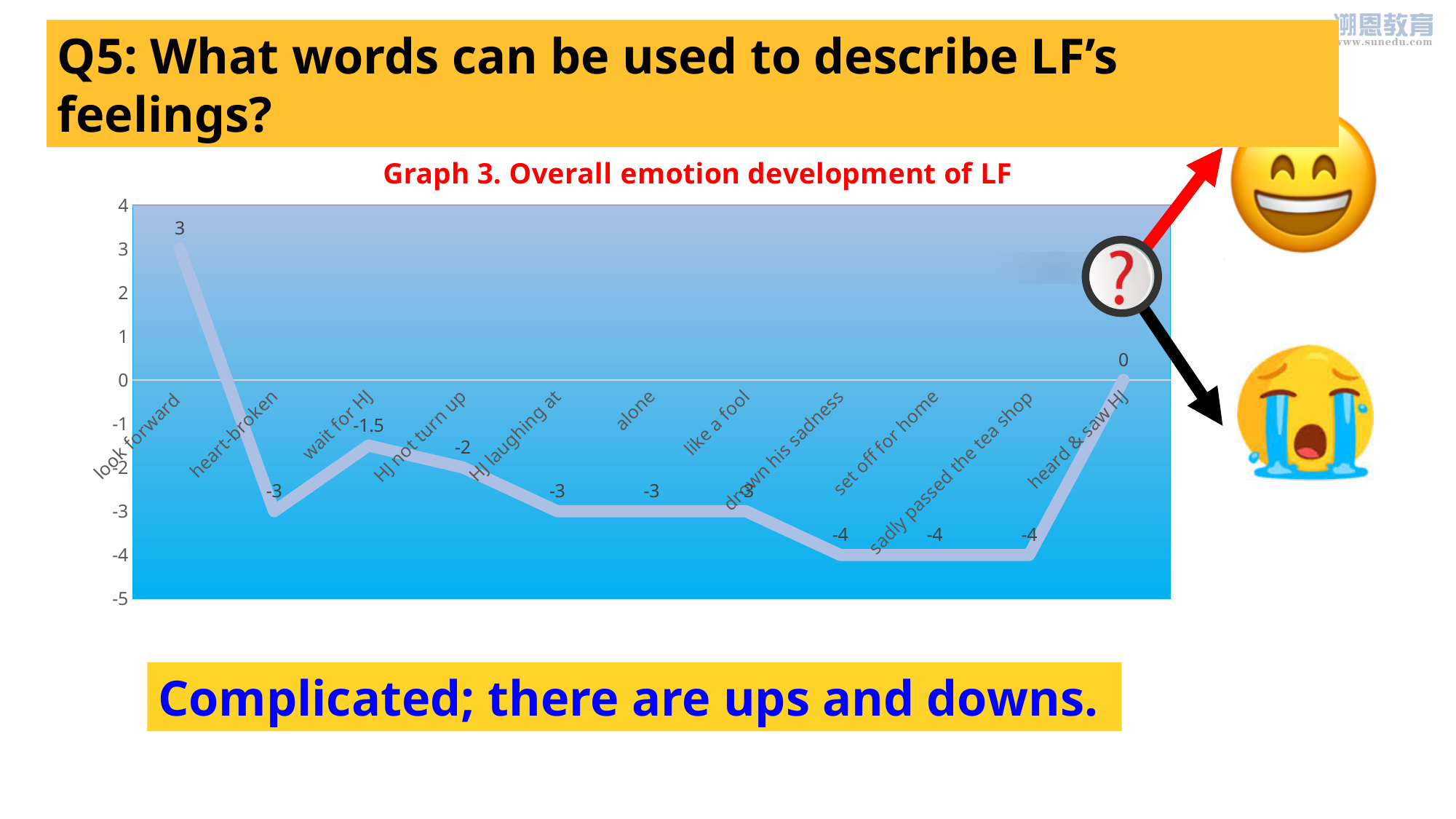
Does the line rise or fall from 'sadly passed the tea shop' to 'heard & saw HJ'? rise What is the difference between the values for 'look forward' and 'heart-broken'? 6 What is the value for 'look forward'? 3 What is the value for 'wait for HJ'? -1.5 What is the value for 'heard & saw HJ'? 0 What type of chart is shown on the slide? line chart What is the value for 'set off for home'? -4 What is the value for 'HJ not turn up'? -2 Which is larger, the value for 'wait for HJ' or the value for 'HJ not turn up'? wait for HJ How many categories are plotted along the x axis? 11 What is the title of the chart? Graph 3. Overall emotion development of LF Which category has the highest value? look forward